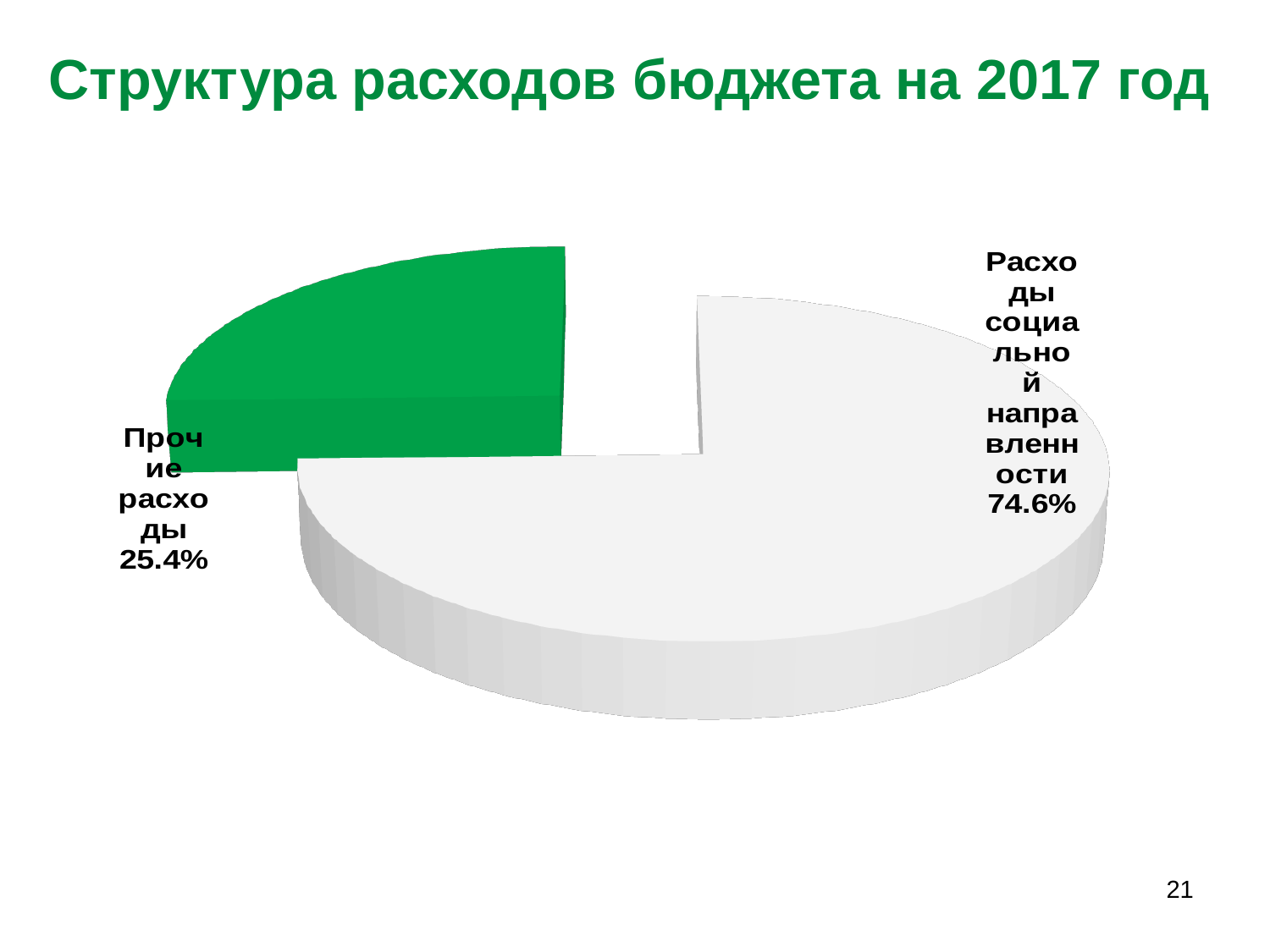
What share of the pie is labelled 'Прочие расходы'? 25.4% Which is larger: the share for 'Прочие расходы' or the share for 'Расходы социальной направленности'? Расходы социальной направленности What colour is the slice for 'Прочие расходы'? green What share of the pie is labelled 'Расходы социальной направленности'? 74.6% What kind of chart is shown on the slide? pie chart How many slices does the pie chart have? 2 What is the difference in percentage points between 'Расходы социальной направленности' and 'Прочие расходы'? 49.2 Which slice of the pie is the largest? Расходы социальной направленности What is the title of the chart on the slide? Структура расходов бюджета на 2017 год Which slice of the pie is the smallest? Прочие расходы